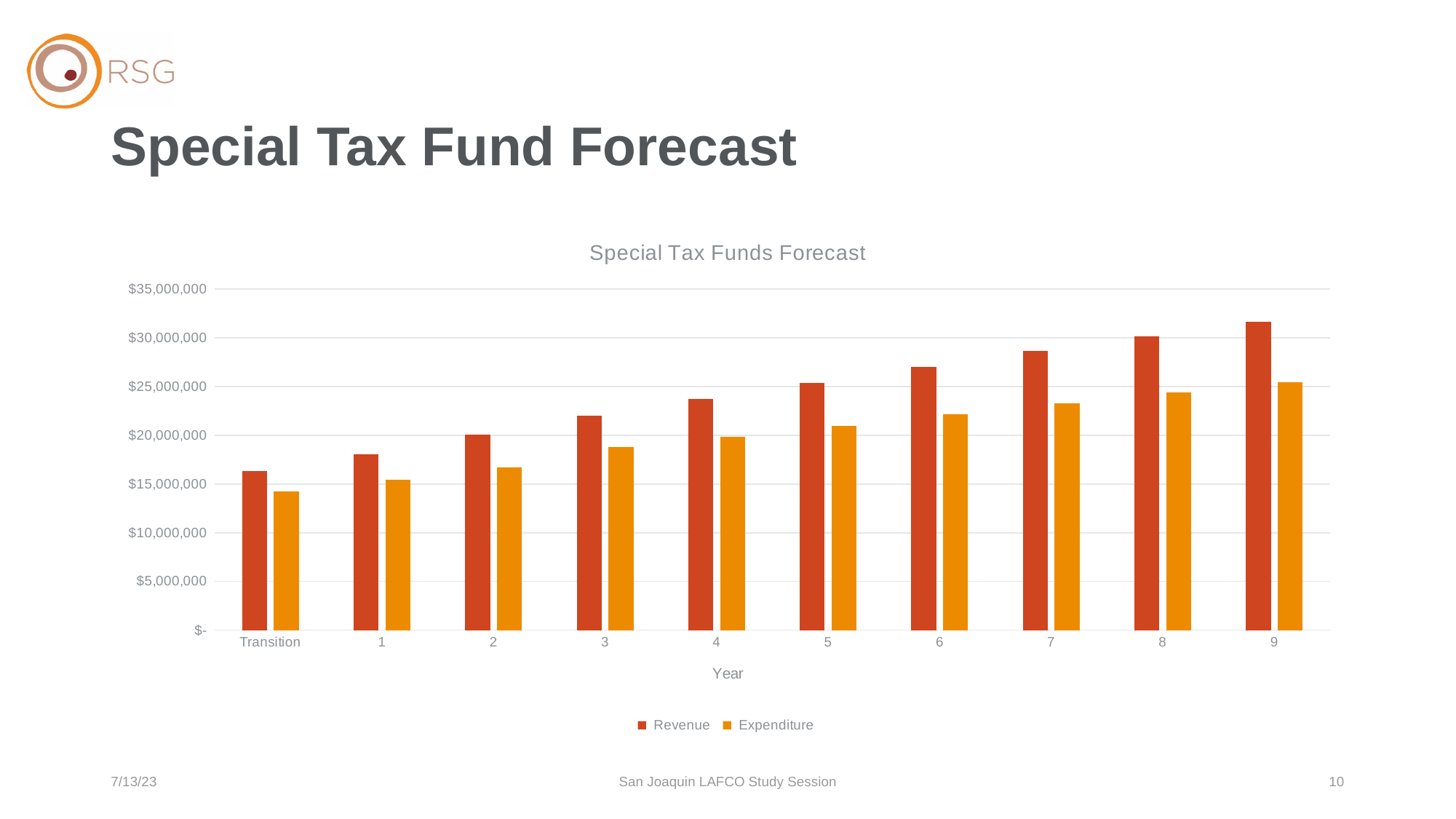
Which year has the highest Revenue? 9 How many categories are shown along the Year axis? 10 Is the Revenue value for year 3 greater or less than $20,000,000? greater Is the Expenditure value for Transition greater or less than $15,000,000? less Is the Expenditure value for year 6 greater or less than $20,000,000? greater How many series does the legend list? 2 What kind of chart is shown on the slide? Bar chart Which category has the lowest Expenditure? Transition In year 5, which is larger, Revenue or Expenditure? Revenue Do the Revenue values rise or fall from Transition to year 9? Rise